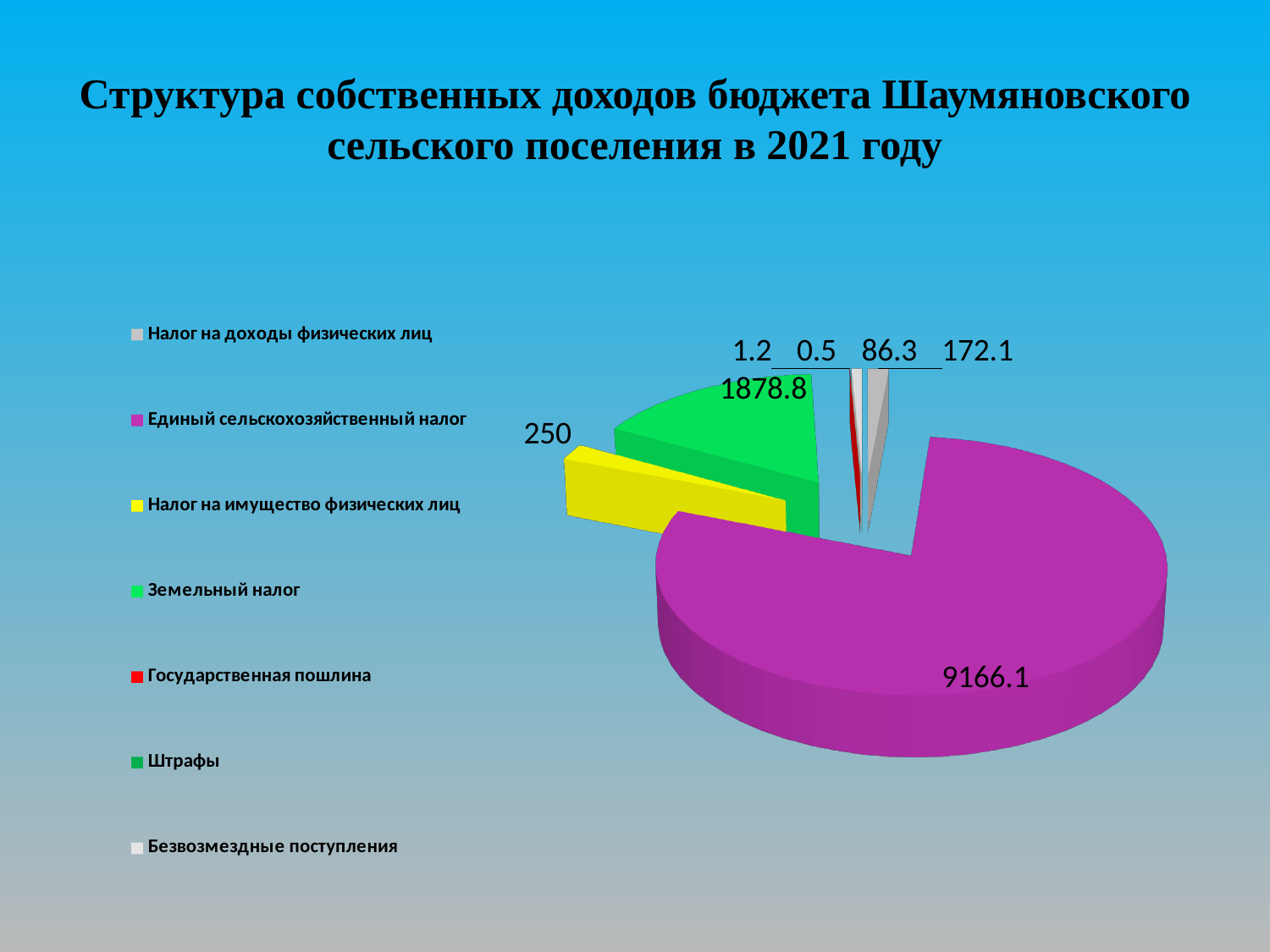
What is the difference between Земельный налог and Налог на имущество физических лиц? 1628.8 Which category has the largest slice of the pie? Единый сельскохозяйственный налог What is the value for Единый сельскохозяйственный налог? 9166.1 Which is larger, Земельный налог or Налог на имущество физических лиц? Земельный налог What is the value for Налог на имущество физических лиц? 250 How many categories does the legend list? 7 What is the smallest value labelled on the chart? 0.5 What is the difference between Единый сельскохозяйственный налог and Земельный налог? 7287.3 What is the value for Земельный налог? 1878.8 What year does the chart title refer to? 2021 What colour is the slice for Единый сельскохозяйственный налог? Magenta (purple) What kind of chart is shown on the slide? Pie chart